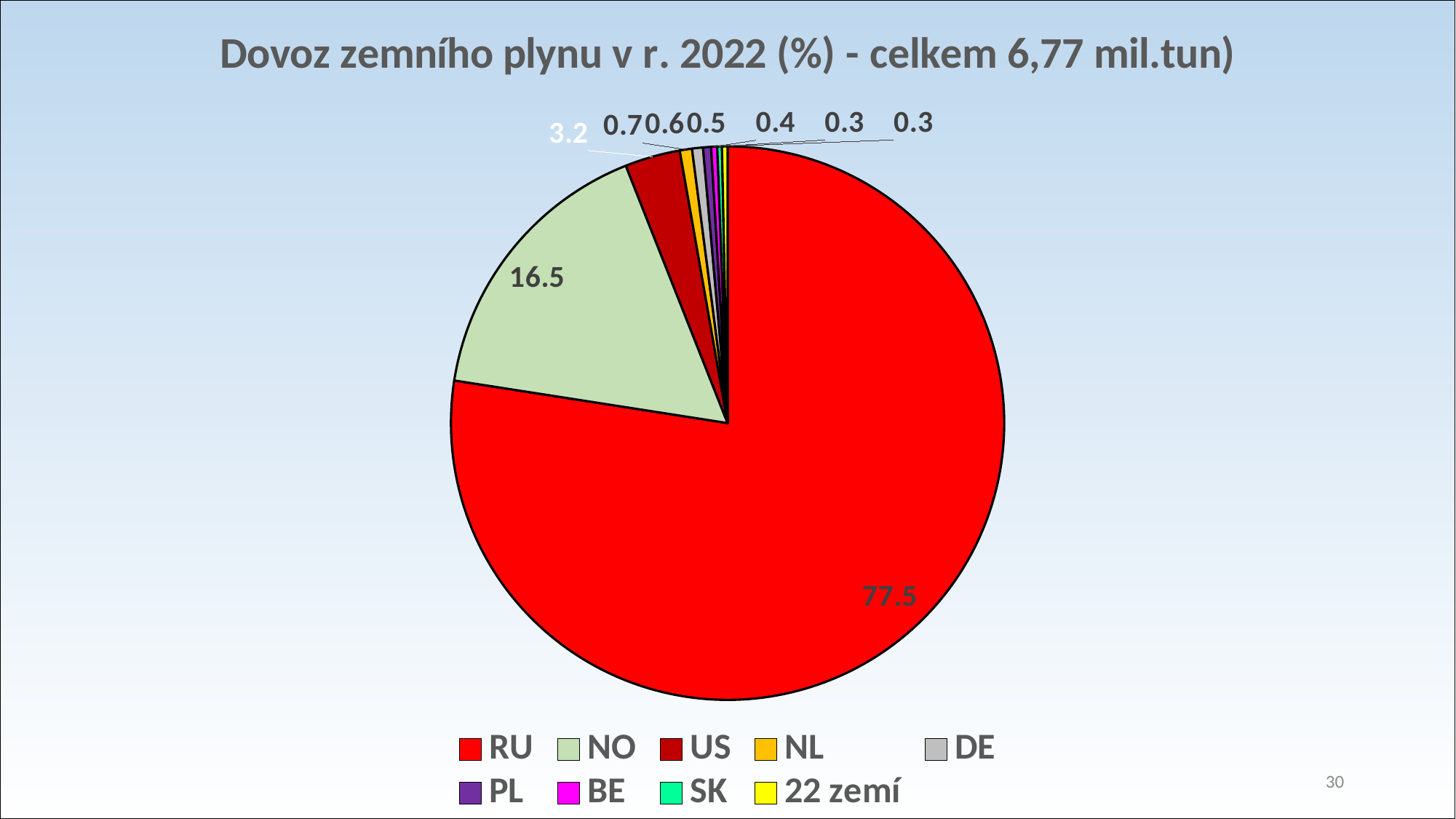
Which category has the largest slice of the pie? RU What is the difference between the values for NO and US? 13.3 Is the value for RU greater or less than 50? greater What is the value shown for US? 3.2 What is the difference between the values for RU and NO? 61 How many entries does the legend list? 9 What kind of chart is shown on the slide? pie chart What is the value shown for RU? 77.5 What is the title of the chart? Dovoz zemního plynu v r. 2022 (%) - celkem 6,77 mil.tun) Which is larger, the slice for NO or the slice for US? NO What is the value shown for NO? 16.5 What colour is the slice for NO? light green